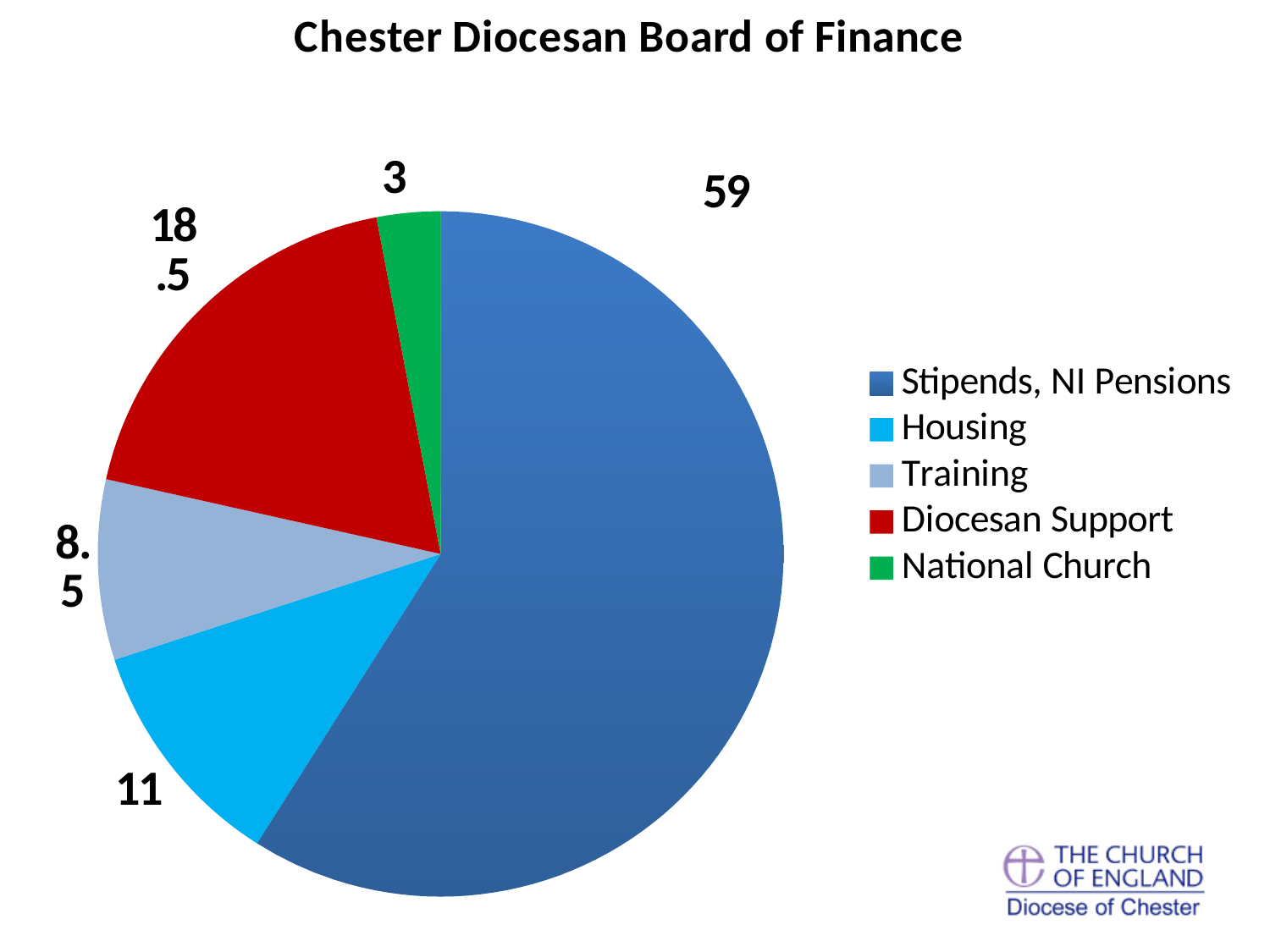
What is the value for Stipends, NI Pensions? 59 What is the difference between the values for Diocesan Support and Housing? 7.5 What type of chart is shown on the slide? pie chart What is the value for Diocesan Support? 18.5 How many categories does the legend list? 5 What is the title of the chart? Chester Diocesan Board of Finance What is the value for Housing? 11 What colour is the Diocesan Support slice? red Which category has the largest slice of the pie? Stipends, NI Pensions Which category has the smallest slice of the pie? National Church Which is larger, the value for Training or the value for Housing? Housing What is the value for National Church? 3